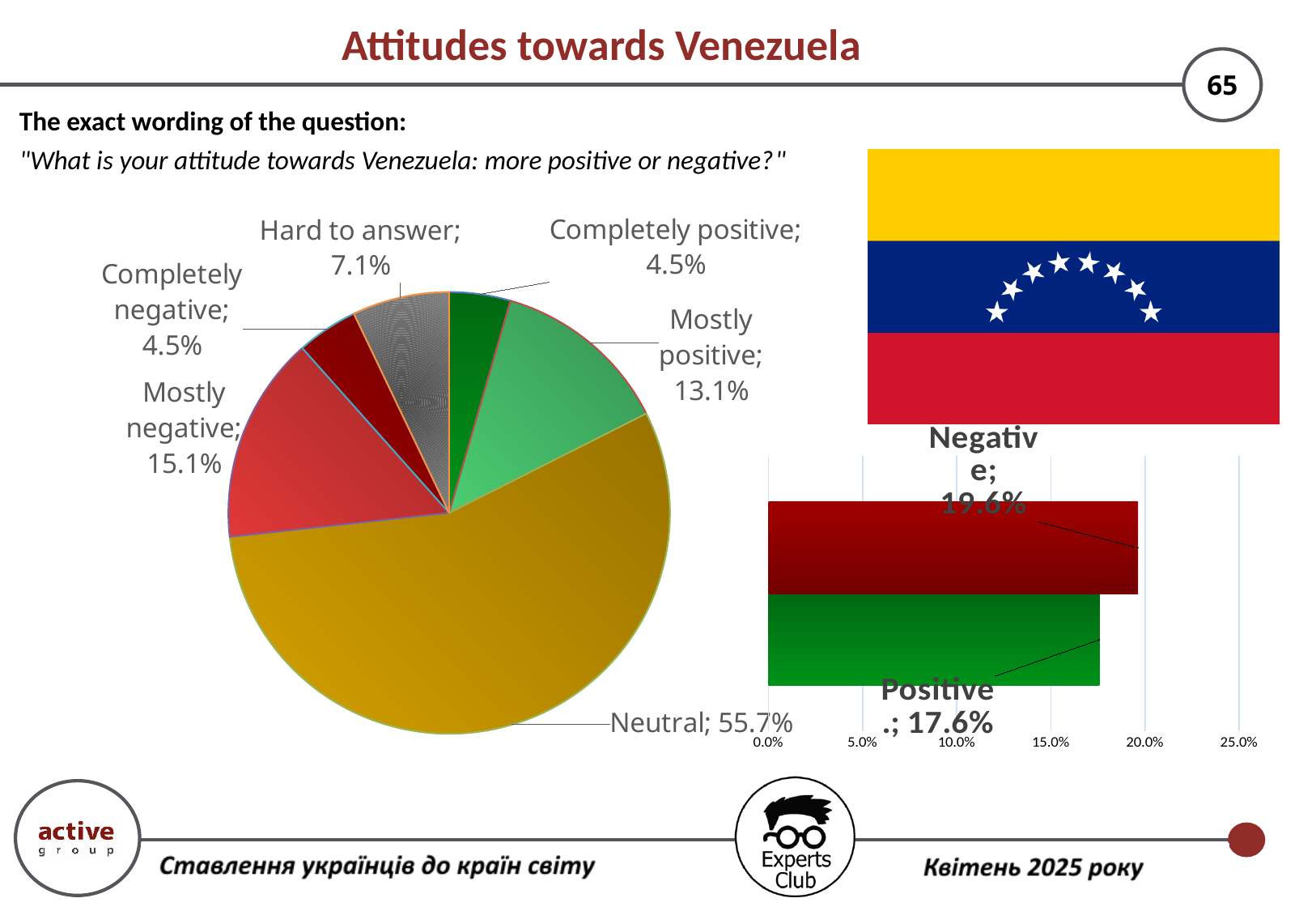
In the bar chart on the right, which category has the higher value? Negative In the pie chart, which category has the largest share? Neutral In the pie chart, what is the value for "Mostly negative"? 15.1% In the pie chart, what is the difference between "Mostly negative" and "Mostly positive"? 2.0% In the pie chart, which is larger: "Mostly positive" or "Hard to answer"? Mostly positive In the bar chart on the right, what is the difference between "Negative" and "Positive"? 2.0% In the bar chart on the right, what is the value for "Positive"? 17.6% What type of chart is shown on the left side of the slide? Pie chart In the pie chart, what is the value for "Hard to answer"? 7.1% In the pie chart, what share of respondents answered "Neutral"? 55.7% In the bar chart on the right, what is the value for "Negative"? 19.6% In the pie chart, how many slices are there? 6